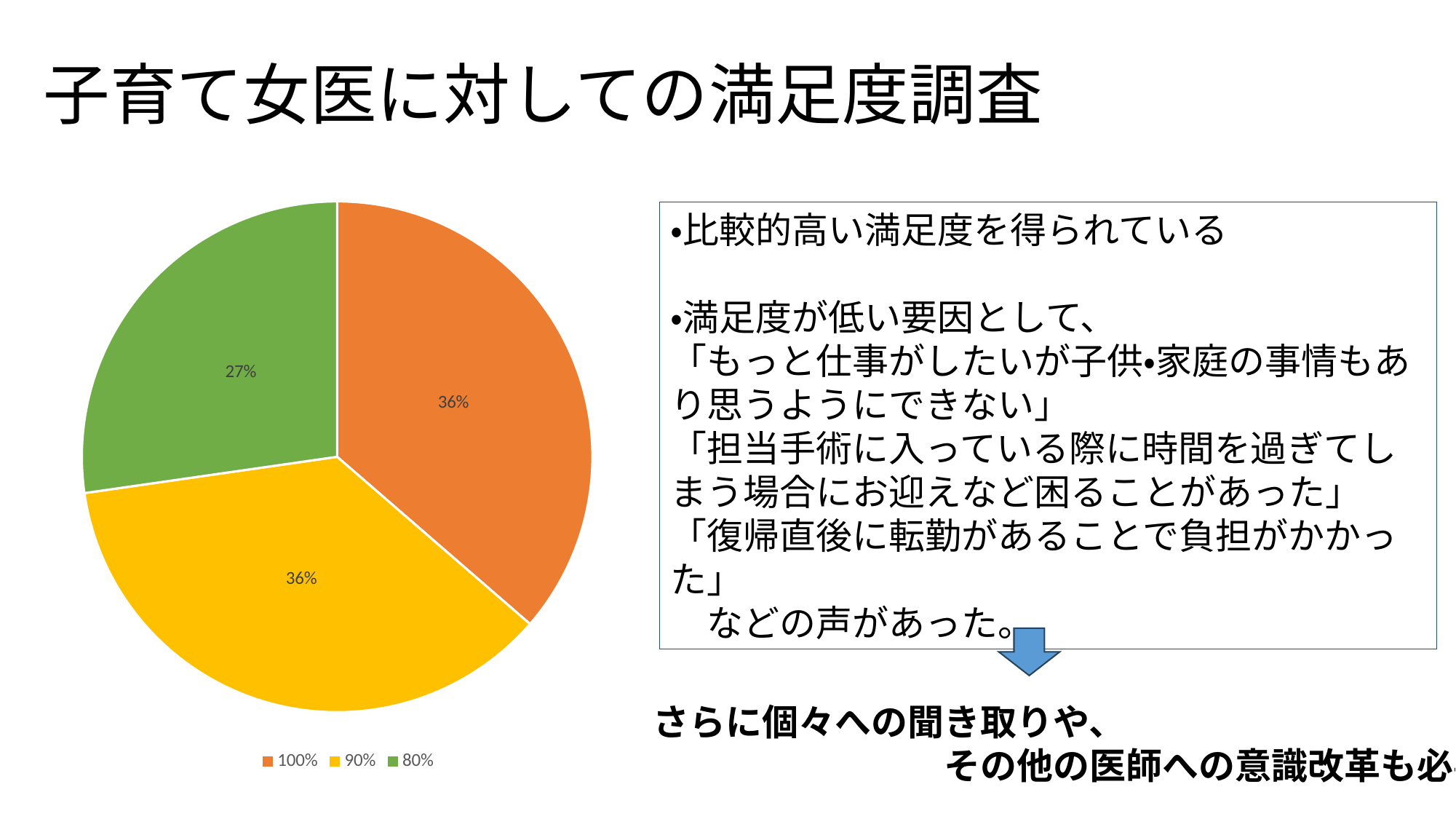
What colour is the slice for the "90%" category? yellow Which slice is larger, the "100%" category or the "80%" category? 100% What is the difference in percentage points between the "100%" slice and the "80%" slice? 9 What kind of chart is shown on the slide? pie chart Which category has the smallest slice of the pie? 80% What share of the pie does the "80%" category take? 27% Which slice is larger, the "90%" category or the "80%" category? 90% How many slices does the pie chart have? 3 What share of the pie does the "90%" category take? 36% What colour is the slice for the "80%" category? green What share of the pie does the "100%" category take? 36% How many entries does the legend of the pie chart list? 3